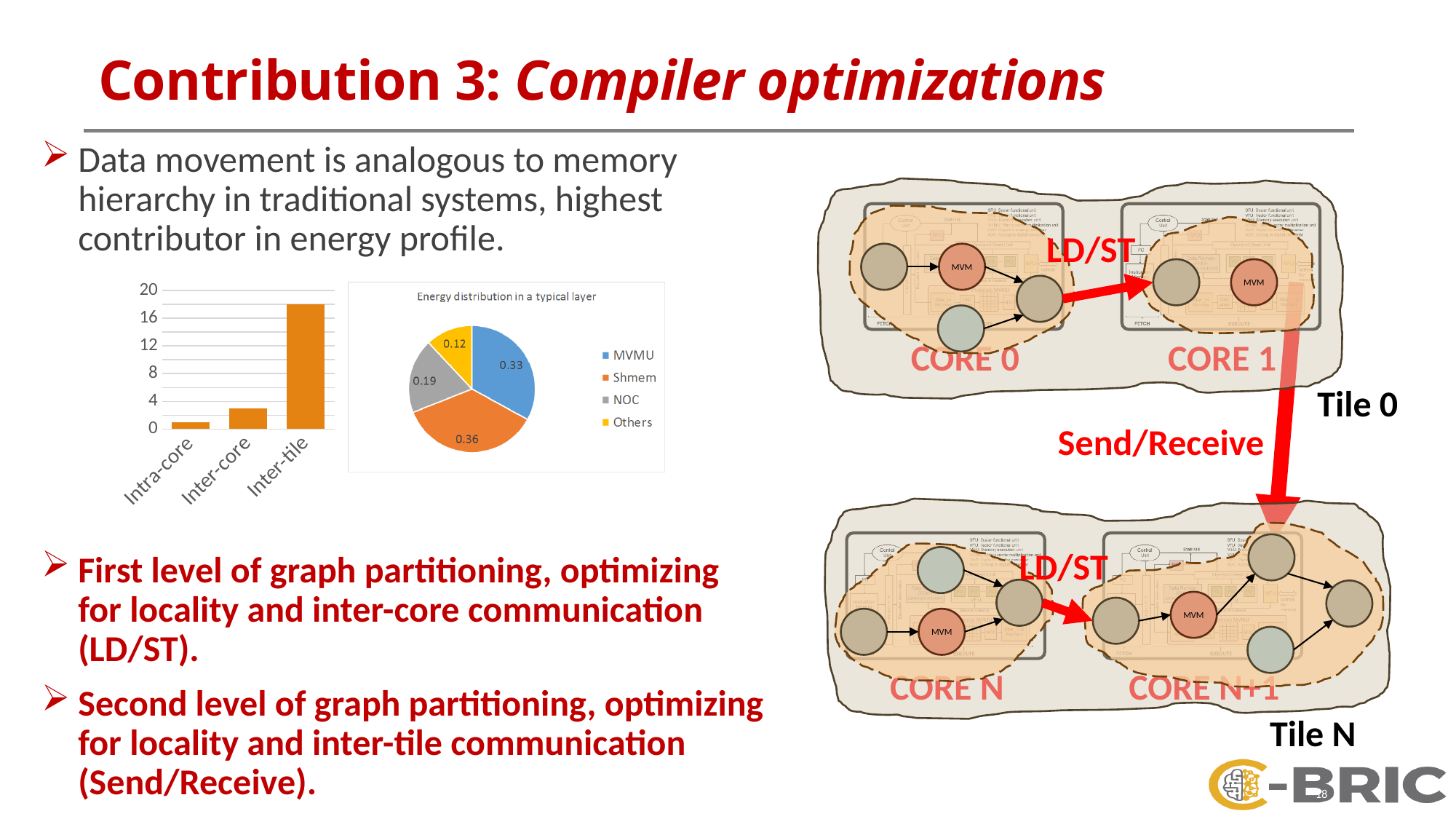
What kind of chart is the chart on the left of the slide? bar chart In the bar chart on the left, which category has the highest value? Inter-tile How many entries does the legend of the pie chart list? 4 In the bar chart on the left, is the value for Inter-tile greater or less than 16? greater In the pie chart 'Energy distribution in a typical layer', which slice is the smallest? Others What is the title of the pie chart? Energy distribution in a typical layer In the pie chart 'Energy distribution in a typical layer', what is the value for NOC? 0.19 In the bar chart on the left, which category has the lowest value? Intra-core In the pie chart 'Energy distribution in a typical layer', what is the difference between the MVMU and Others values? 0.21 In the bar chart on the left, is the value for Inter-core greater or less than 4? less In the pie chart 'Energy distribution in a typical layer', what is the value for Shmem? 0.36 How many categories does the bar chart on the left show? 3